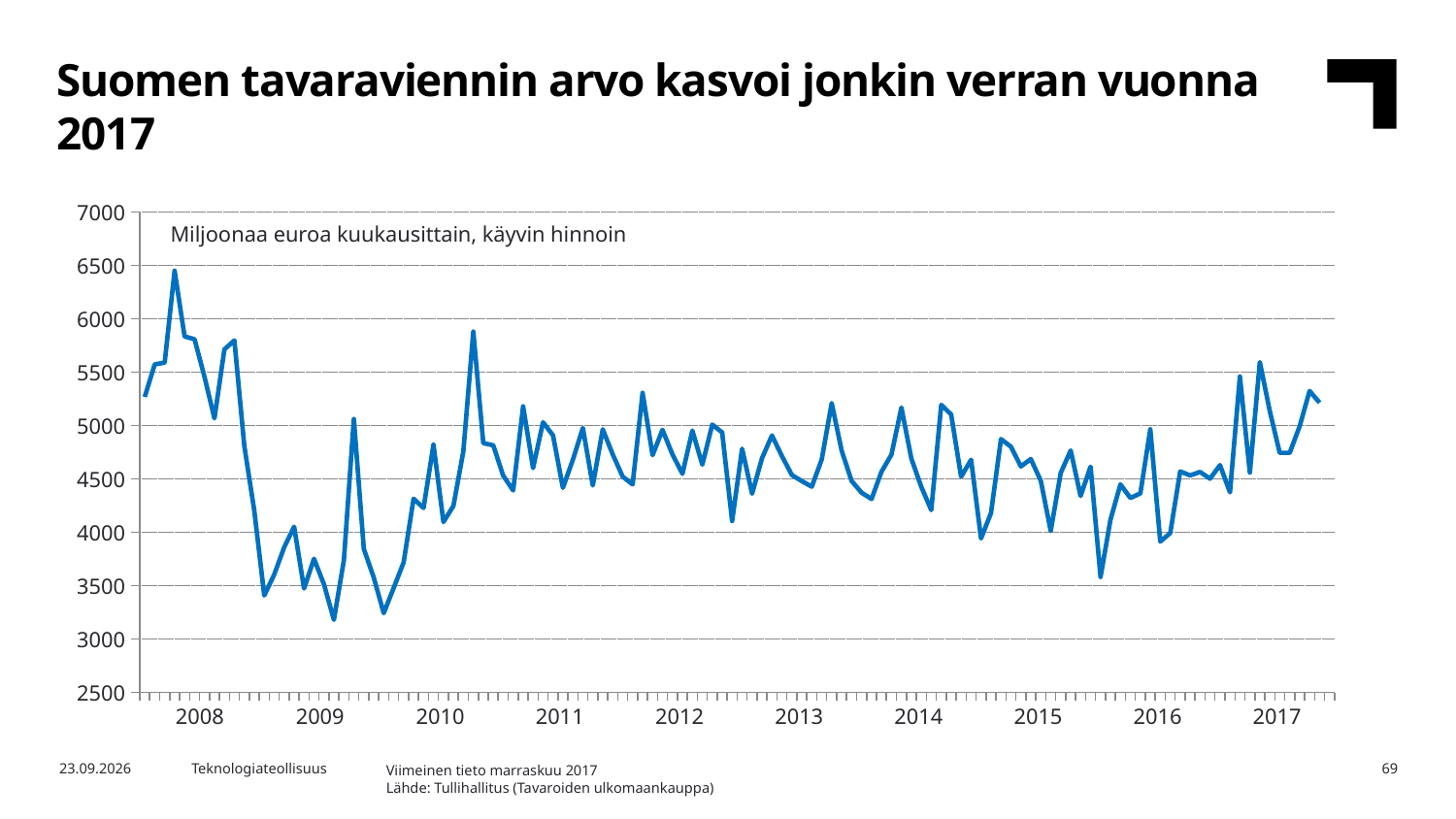
In which year does the line reach its lowest point? 2009 What unit description is printed inside the chart area? Miljoonaa euroa kuukausittain, käyvin hinnoin In which year does the line reach its highest peak? 2008 What is the title of the slide? Suomen tavaraviennin arvo kasvoi jonkin verran vuonna 2017 How many lines (data series) are plotted on the chart? 1 Is the lowest point in 2009 greater or less than 3500? less Is the lowest point in 2015 greater or less than 4000? less How many years are labelled on the x axis? 10 Is the last plotted value in 2017 greater or less than 5000? greater What kind of chart is shown on the slide? Line chart Do the values generally rise or fall from the start of 2008 to the start of 2009? fall